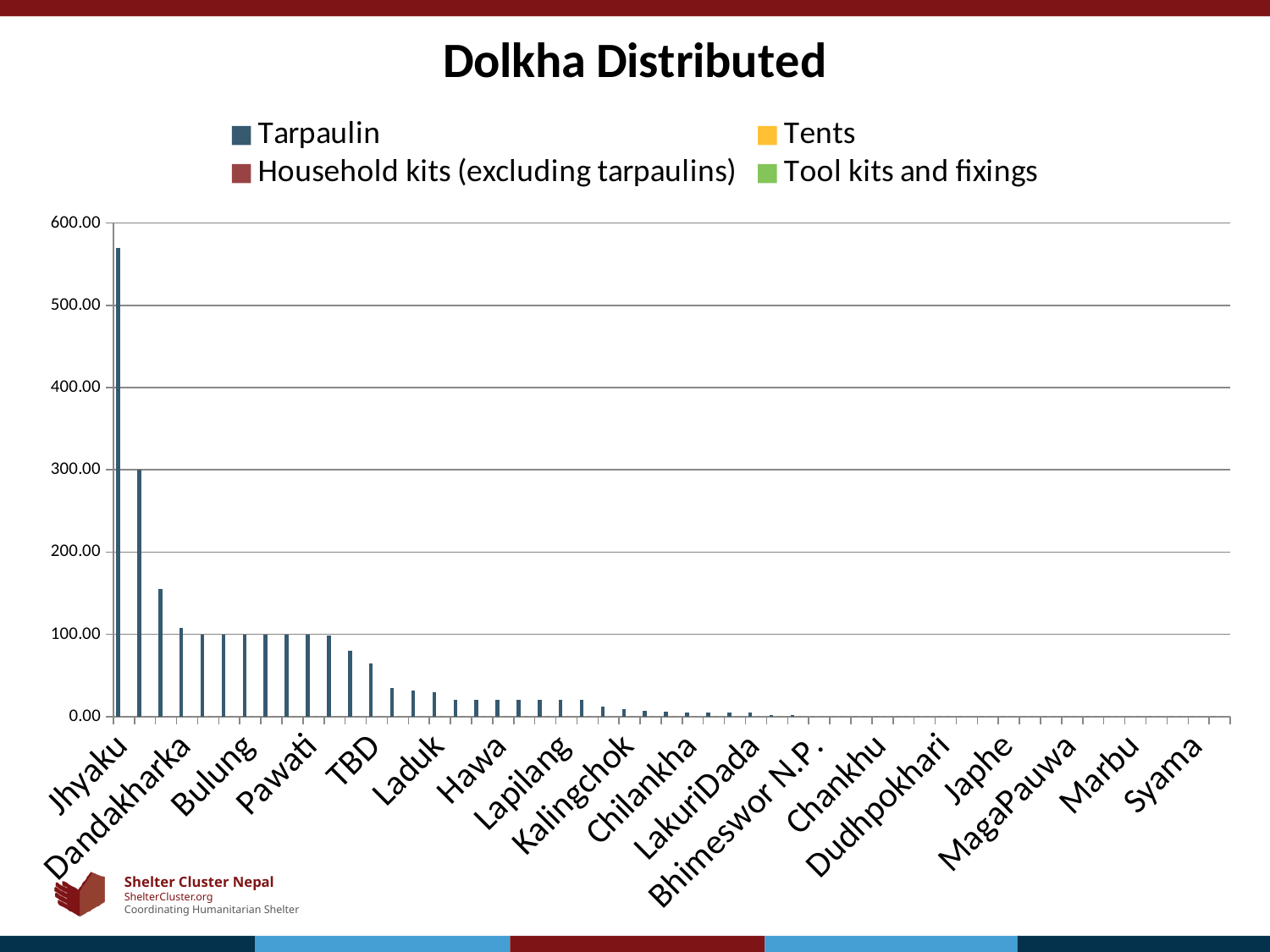
Which is larger, the value for Jhyaku or the value for Dandakharka? Jhyaku Do the values rise or fall moving from left to right along the x axis? fall Which is larger, the value for Dandakharka or the value for TBD? Dandakharka Is the value for Dandakharka greater or less than 200? less How many series does the legend list? 4 Which category has the highest value? Jhyaku Is the value for Laduk greater or less than 100? less Which legend entry is shown in blue? Tarpaulin What kind of chart is shown on the slide? bar chart Is the value for Jhyaku greater or less than 500? greater What is the title of the chart? Dolkha Distributed